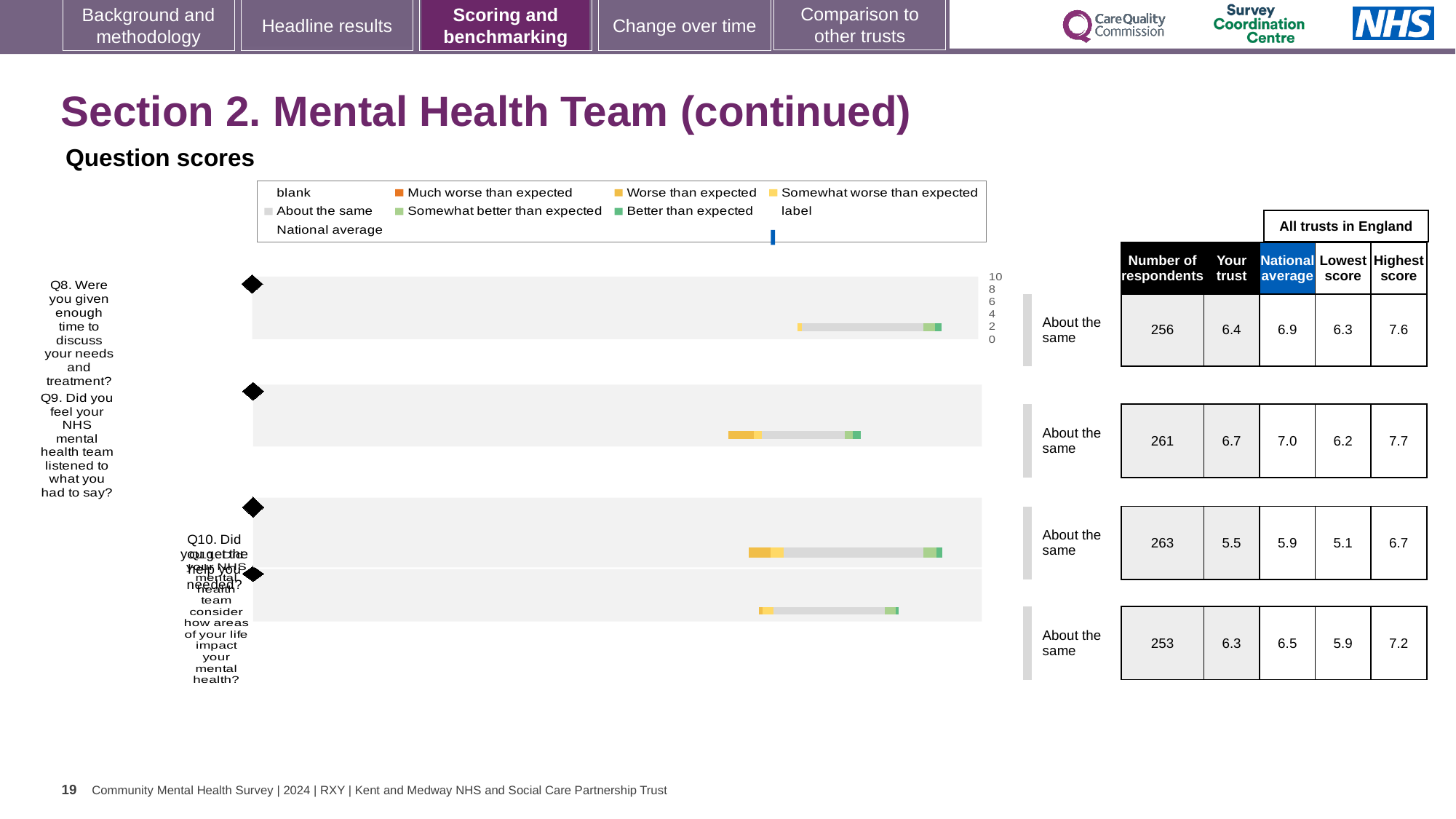
For Q9, which is larger: the 'Your trust' score or the national average? National average Which of Q8, Q9 and Q10 has the highest 'Your trust' score? Q9 For Q8, what is the difference between the highest score and the lowest score across all trusts in England? 1.3 How many respondents answered Q10 (Did you get the help you needed?)? 263 What benchmark category is shown for every question in the Question scores chart? About the same What is the national average score for Q9 (Did you feel your NHS mental health team listened to what you had to say?)? 7.0 For Q10, how much higher is the national average than the 'Your trust' score? 0.4 What is the title of the chart on this slide? Question scores How many questions are plotted in the Question scores chart? 4 What kind of chart is used to show the question scores on this slide? bar chart What is the 'Your trust' score for Q8 (Were you given enough time to discuss your needs and treatment?)? 6.4 Which of Q8, Q9 and Q10 has the lowest 'Your trust' score? Q10